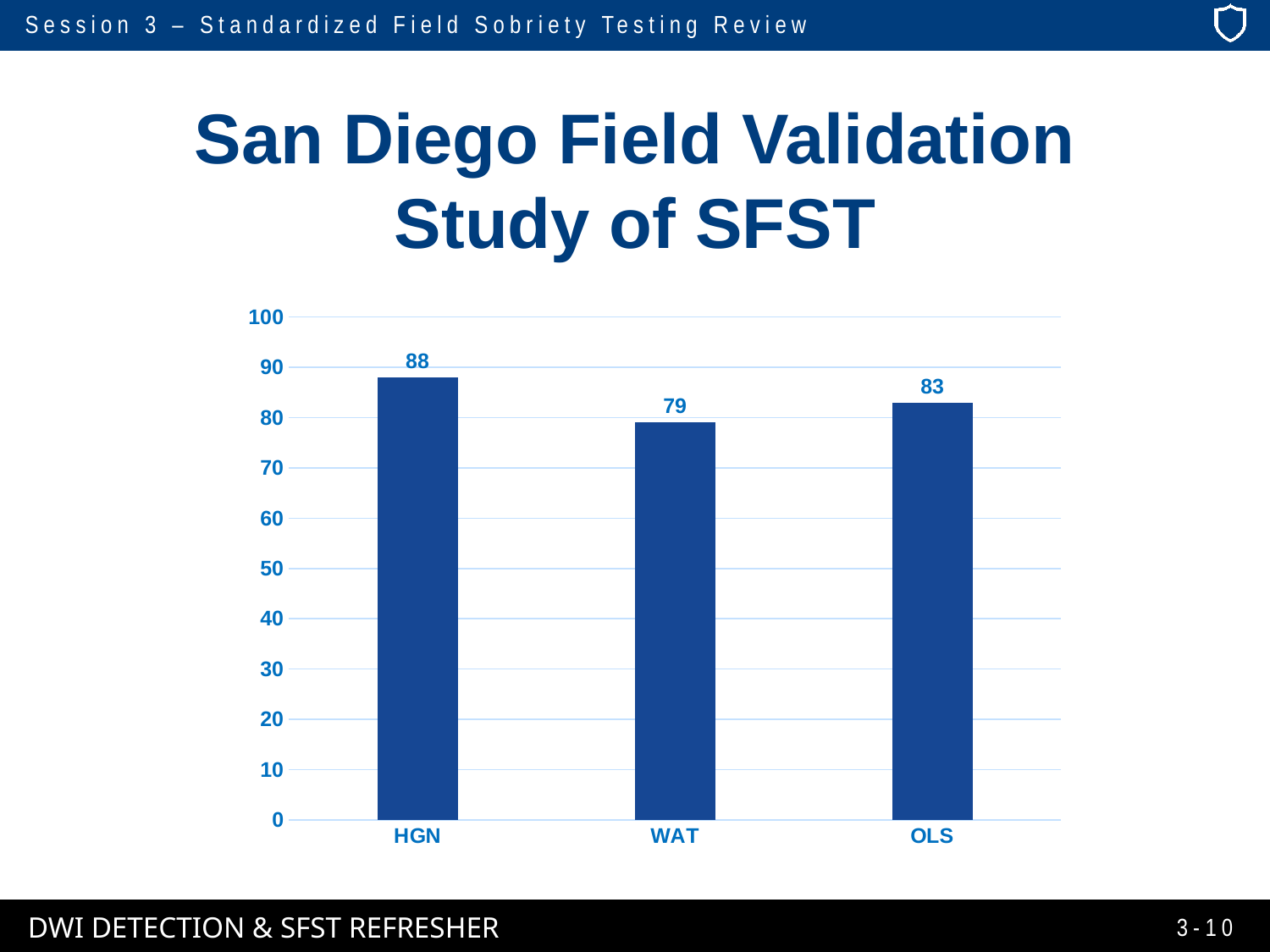
Which category has the highest value? HGN What is the difference between the values for HGN and WAT? 9 Which category has the lowest value? WAT What kind of chart is shown on the slide? bar chart How many categories are shown on the x axis? 3 What is the title of the slide containing the chart? San Diego Field Validation Study of SFST Which is larger, the value for OLS or the value for WAT? OLS What is the value for OLS? 83 What is the difference between the values for OLS and WAT? 4 What is the value for WAT? 79 Is the value for WAT greater or less than 80? less What is the value for HGN? 88